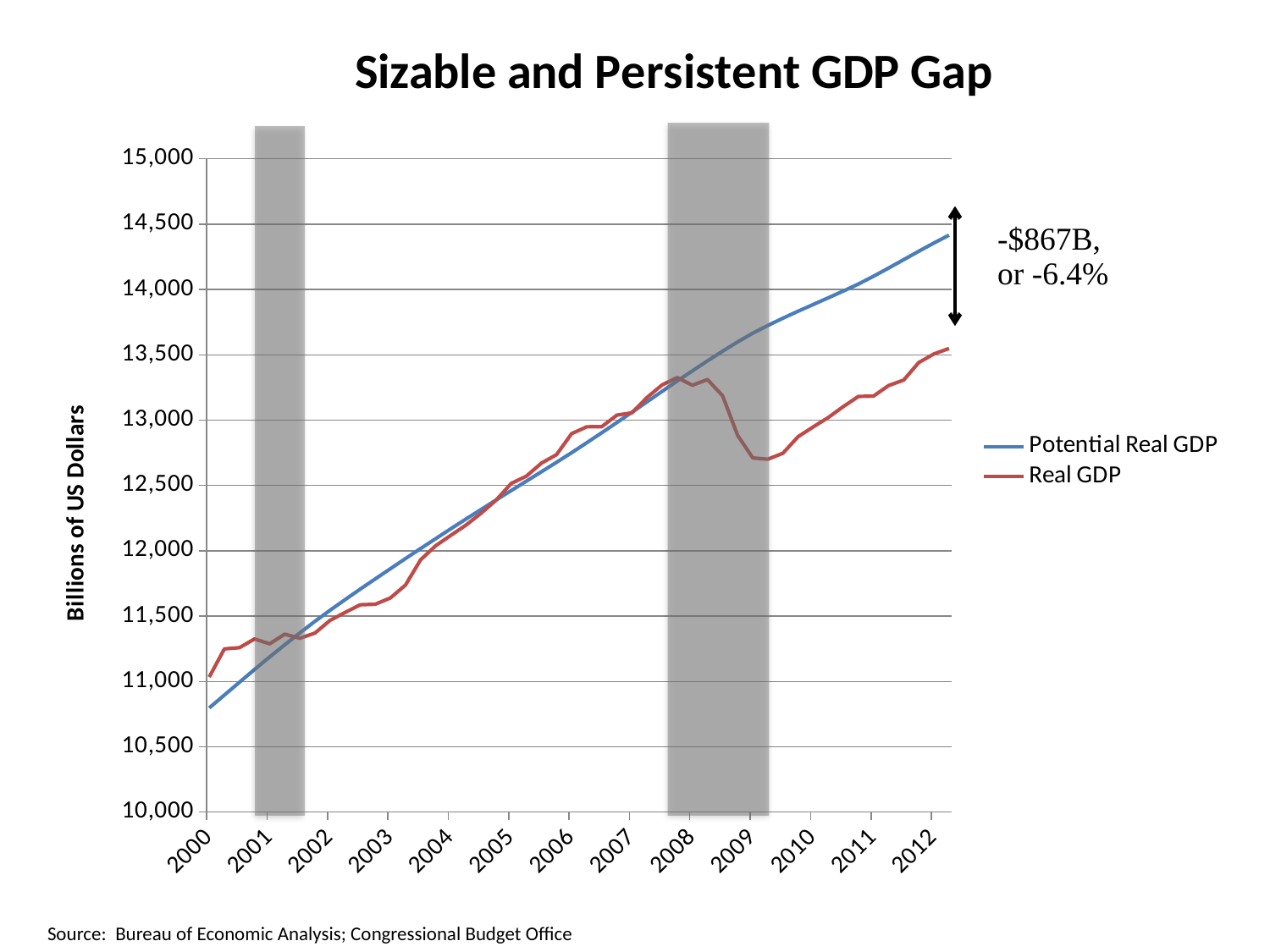
What kind of chart is shown on the slide? Line chart Is the value for Real GDP in 2012 greater or less than 14,000? less What is the title of the chart? Sizable and Persistent GDP Gap Is the value for Potential Real GDP in 2012 greater or less than 14,000? greater Does the Potential Real GDP line rise or fall from 2000 to 2012? Rise How many year labels are shown on the x axis? 13 What is the label on the vertical axis? Billions of US Dollars According to the annotation, what is the GDP gap in dollars at the end of the series? -$867B Is the value for Real GDP in 2009 greater or less than 13,000? less In 2012, which series has the higher value, Potential Real GDP or Real GDP? Potential Real GDP How many series does the legend list? 2 According to the annotation, what is the GDP gap as a percentage at the end of the series? -6.4%